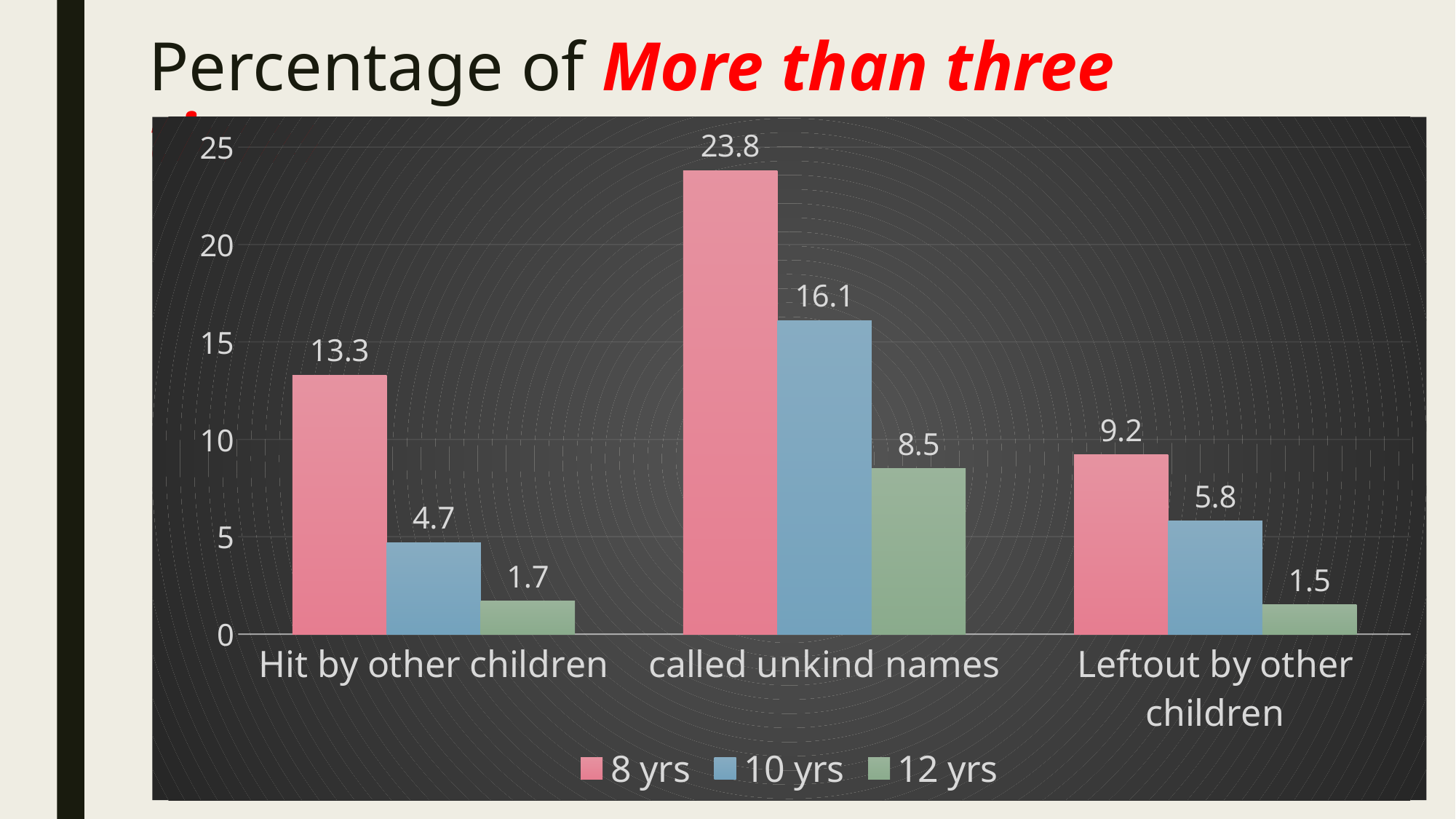
What kind of chart is shown on the slide? bar chart What is the value for 8 yrs in the 'called unkind names' category? 23.8 Which series is shown in green in the legend? 12 yrs How many series does the legend list? 3 Which category has the lowest value for the 12 yrs series? Leftout by other children Which category has the highest value for the 8 yrs series? called unkind names What is the difference between the 8 yrs and 10 yrs values in the 'called unkind names' category? 7.7 Is the value for 10 yrs in 'called unkind names' greater or less than 15? greater How many categories are shown on the x axis? 3 What is the value for 12 yrs in the 'Hit by other children' category? 1.7 Which is larger: the 10 yrs value for 'Hit by other children' or the 10 yrs value for 'Leftout by other children'? Leftout by other children What is the value for 10 yrs in the 'Leftout by other children' category? 5.8